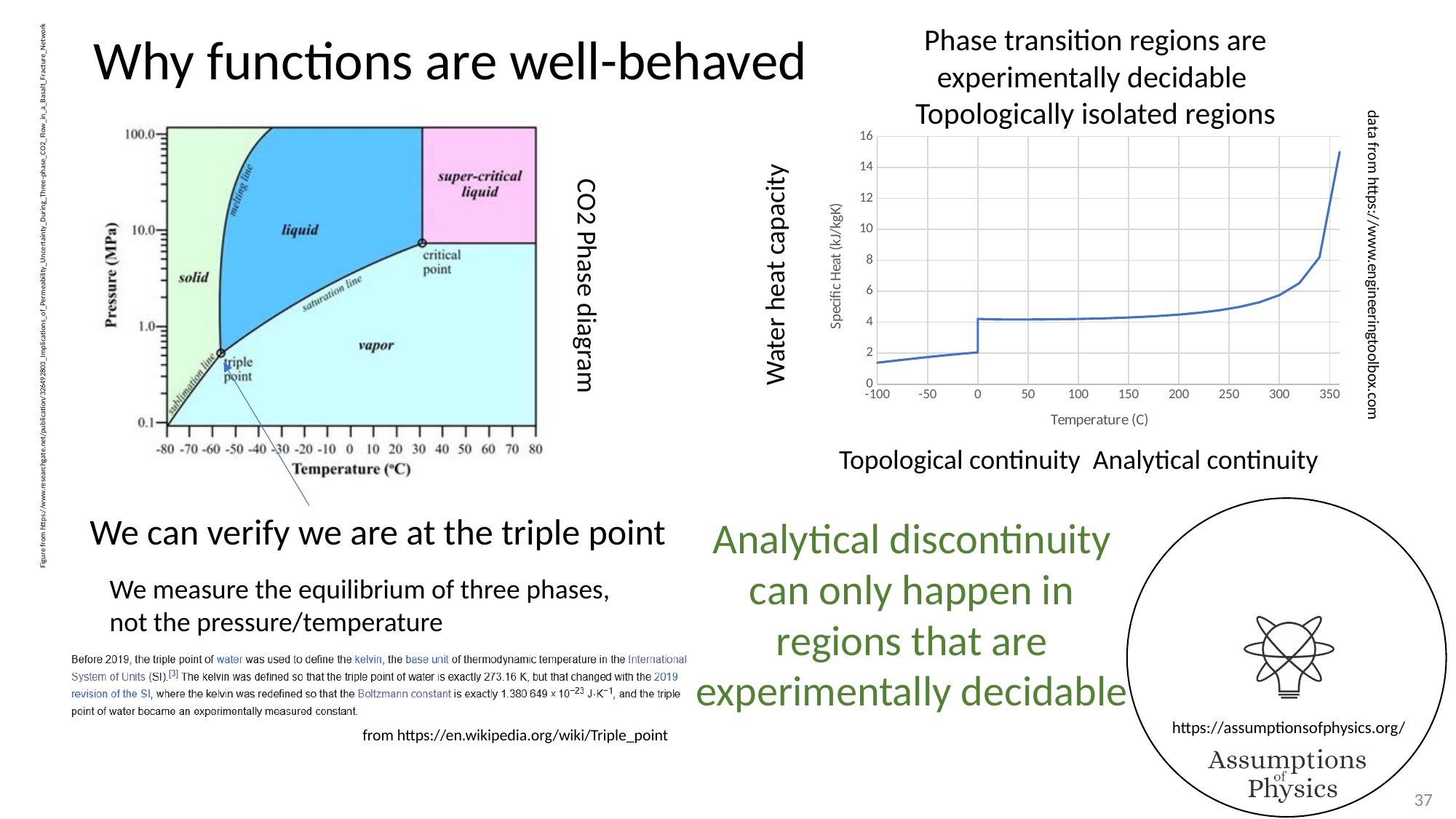
In the CO2 Phase diagram, which phase region lies at the highest temperatures and pressures (top right)? super-critical liquid In the Water heat capacity chart, which has the higher specific heat: the point at -50 C or the point at 50 C? 50 C In the Water heat capacity chart, is the specific heat at a temperature of 200 C greater or less than 6? less In the CO2 Phase diagram, what is the highest pressure value shown on the y-axis? 100.0 What kind of chart is the Water heat capacity chart on the right of the slide? line chart In the Water heat capacity chart, does the specific heat generally rise or fall as temperature increases from -100 C to 350 C? rise In the Water heat capacity chart, is the specific heat at the highest plotted temperature greater or less than 12? greater What is the y-axis label of the Water heat capacity chart? Specific Heat (kJ/kgK) In the Water heat capacity chart, at which temperature does the line show a sudden jump in specific heat? 0 In the Water heat capacity chart, is the specific heat at a temperature of 300 C greater or less than 8? less